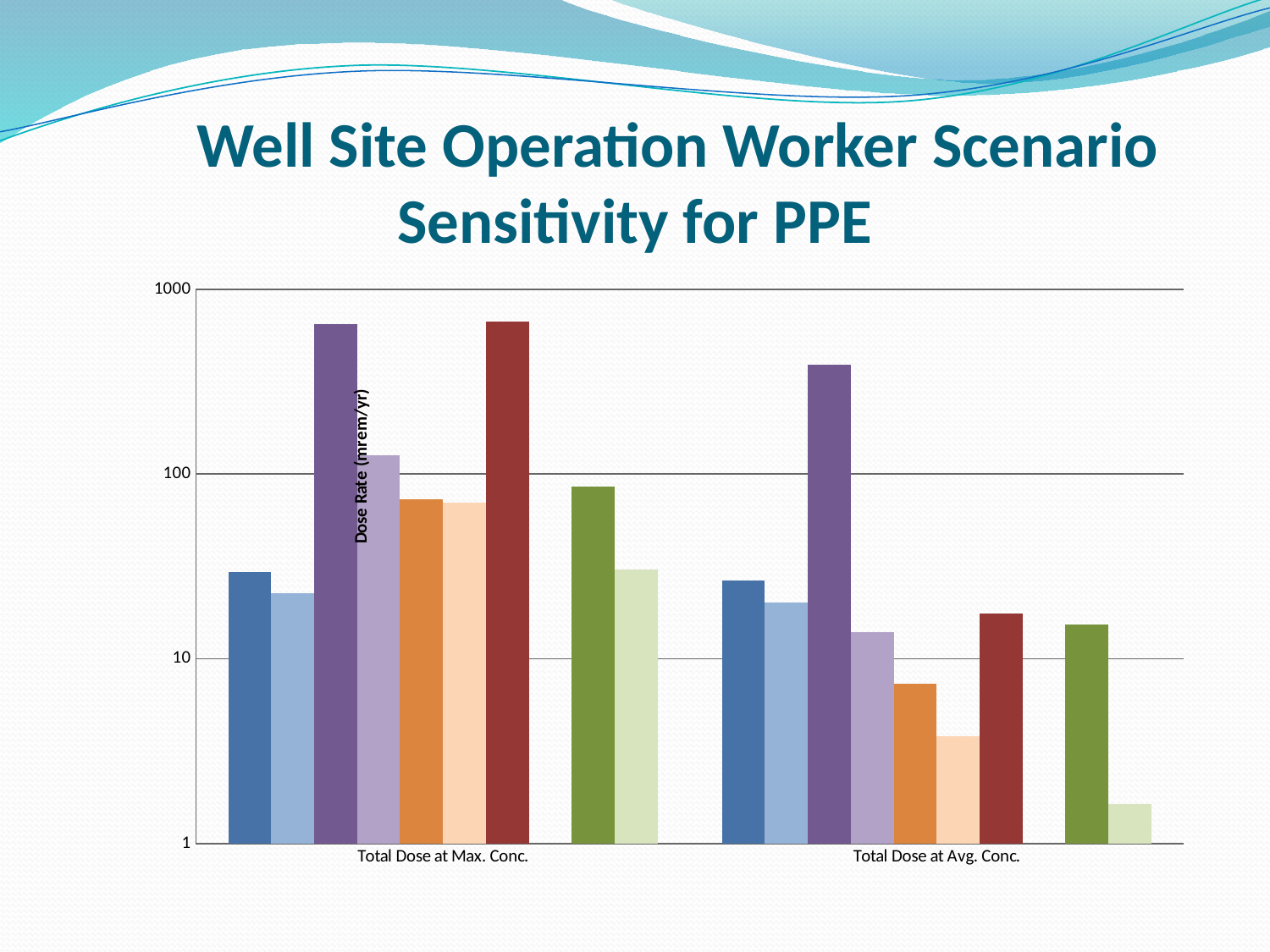
How many categories are shown on the x axis of the chart? 2 What kind of chart is shown on the slide? bar chart Is the value of the dark red bar for Total Dose at Avg. Conc. greater or less than 100? less Is the value of the orange bar for Total Dose at Max. Conc. greater or less than 10? greater For the purple bar, which category has the larger value: Total Dose at Max. Conc. or Total Dose at Avg. Conc.? Total Dose at Max. Conc. Is the value of the dark red bar for Total Dose at Max. Conc. greater or less than 100? greater What is the label of the y axis of the chart? Dose Rate (mrem/yr) What is the title shown above the chart? Well Site Operation Worker Scenario Sensitivity for PPE Within Total Dose at Max. Conc., which is larger: the purple bar or the orange bar? the purple bar